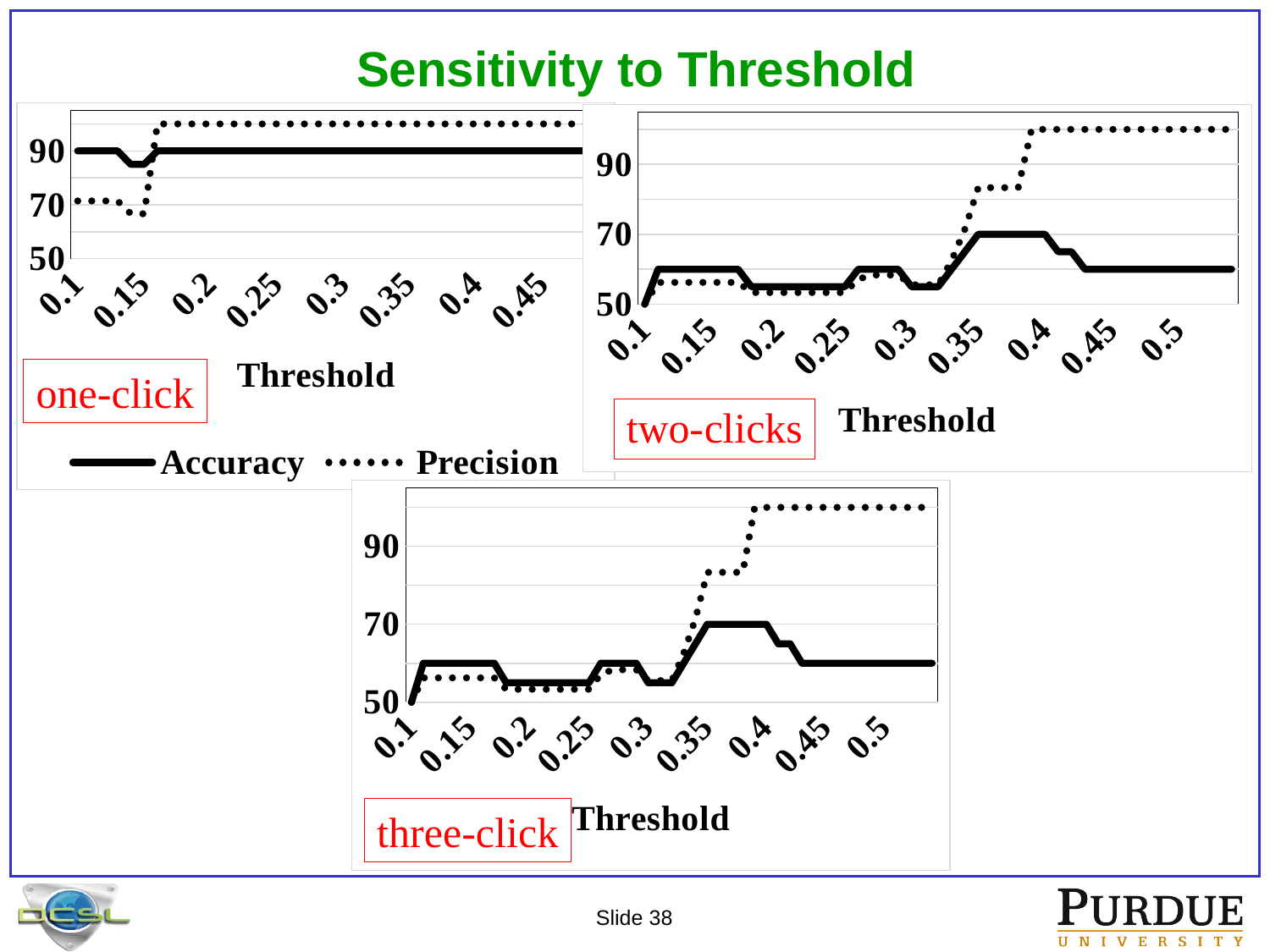
How many series does the legend on the one-click chart list? 2 In the three-click chart, does the Precision series generally rise or fall as the threshold increases? rise In the one-click chart, is the Precision value at threshold 0.4 greater or less than 90? greater In the two-clicks chart, is the Precision value at threshold 0.5 greater or less than 90? greater In the three-click chart, is the Precision value at threshold 0.2 greater or less than 70? less In the two-clicks chart, which series is larger at threshold 0.5, Accuracy or Precision? Precision What kind of chart is the one-click chart? line chart How many threshold values are labelled on the x axis of the one-click chart? 8 In the one-click chart, which series is larger at threshold 0.15, Accuracy or Precision? Accuracy How many threshold values are labelled on the x axis of the two-clicks chart? 9